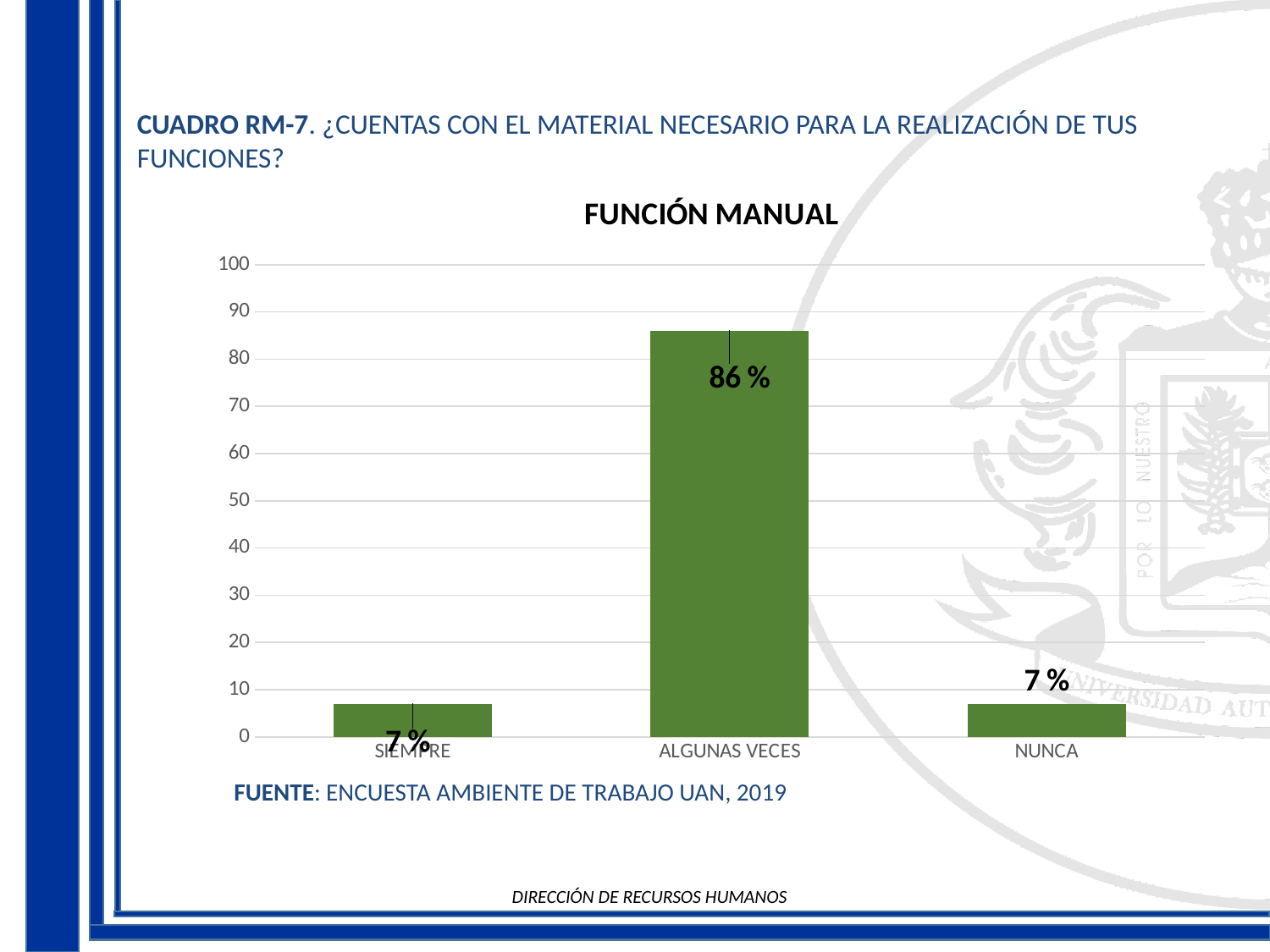
What is the value for SIEMPRE? 7 % Is the value for SIEMPRE greater or less than 10? less Which is larger, the value for ALGUNAS VECES or the value for NUNCA? ALGUNAS VECES What colour are the bars in the chart? green Is the value for ALGUNAS VECES greater or less than 80? greater How many categories are shown on the x axis? 3 What is the value for ALGUNAS VECES? 86 % What is the value for NUNCA? 7 % What is the title of the chart? FUNCIÓN MANUAL Which category has the highest value? ALGUNAS VECES What is the difference between the values for ALGUNAS VECES and SIEMPRE? 79 % What kind of chart is shown on the slide? bar chart